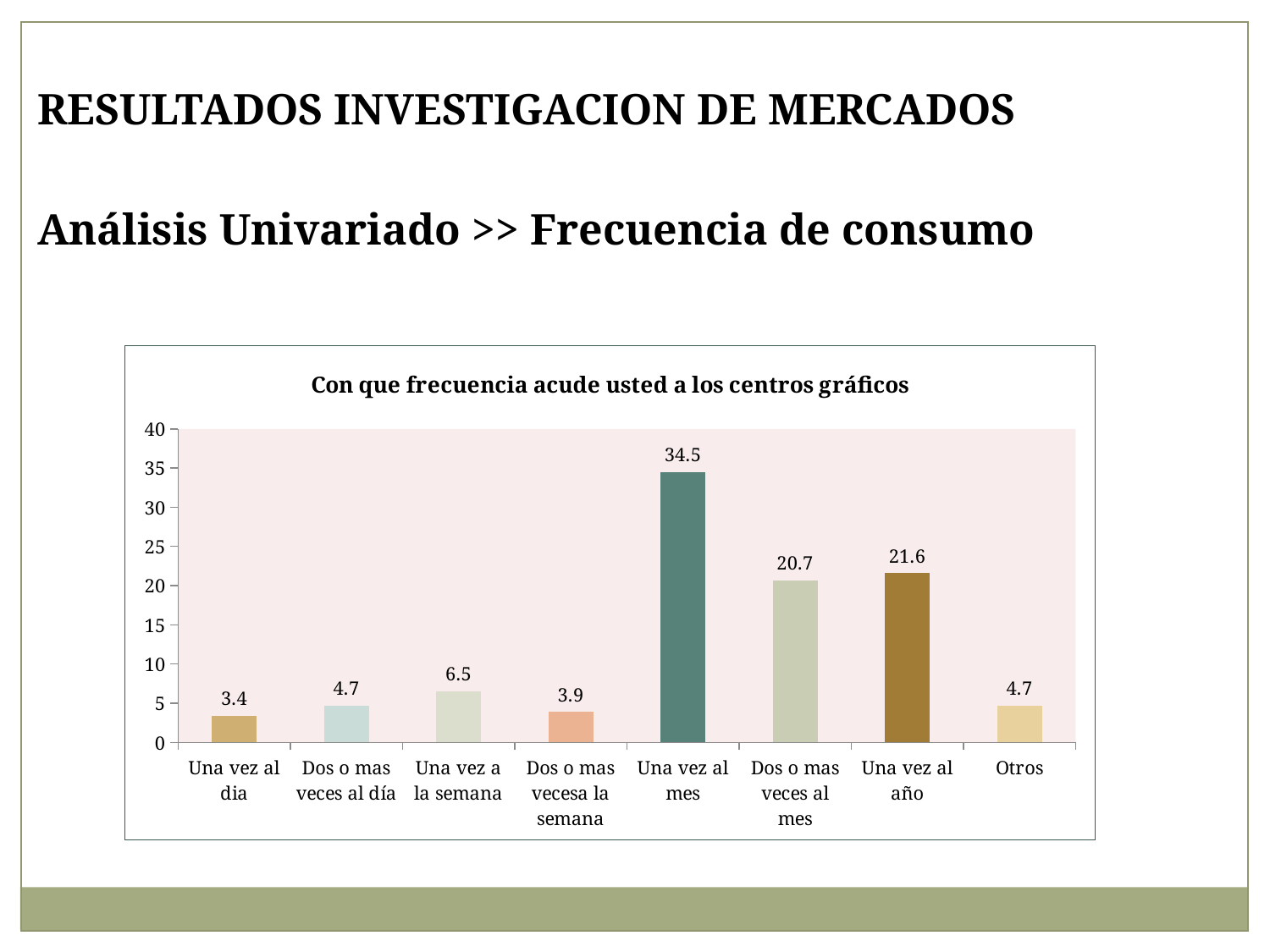
What is the value for "Una vez al año"? 21.6 What is the difference between the values for "Una vez al mes" and "Dos o mas veces al mes"? 13.8 What is the difference between the values for "Una vez a la semana" and "Una vez al dia"? 3.1 What is the value for "Una vez al mes"? 34.5 Is the value for "Una vez al mes" greater or less than 30? greater What kind of chart is shown? bar chart What is the title of the chart? Con que frecuencia acude usted a los centros gráficos Which category has the lowest value? Una vez al dia What is the value for "Una vez a la semana"? 6.5 How many categories are shown on the x axis? 8 Which is larger, the value for "Una vez al año" or the value for "Dos o mas veces al mes"? Una vez al año Which category has the highest value? Una vez al mes